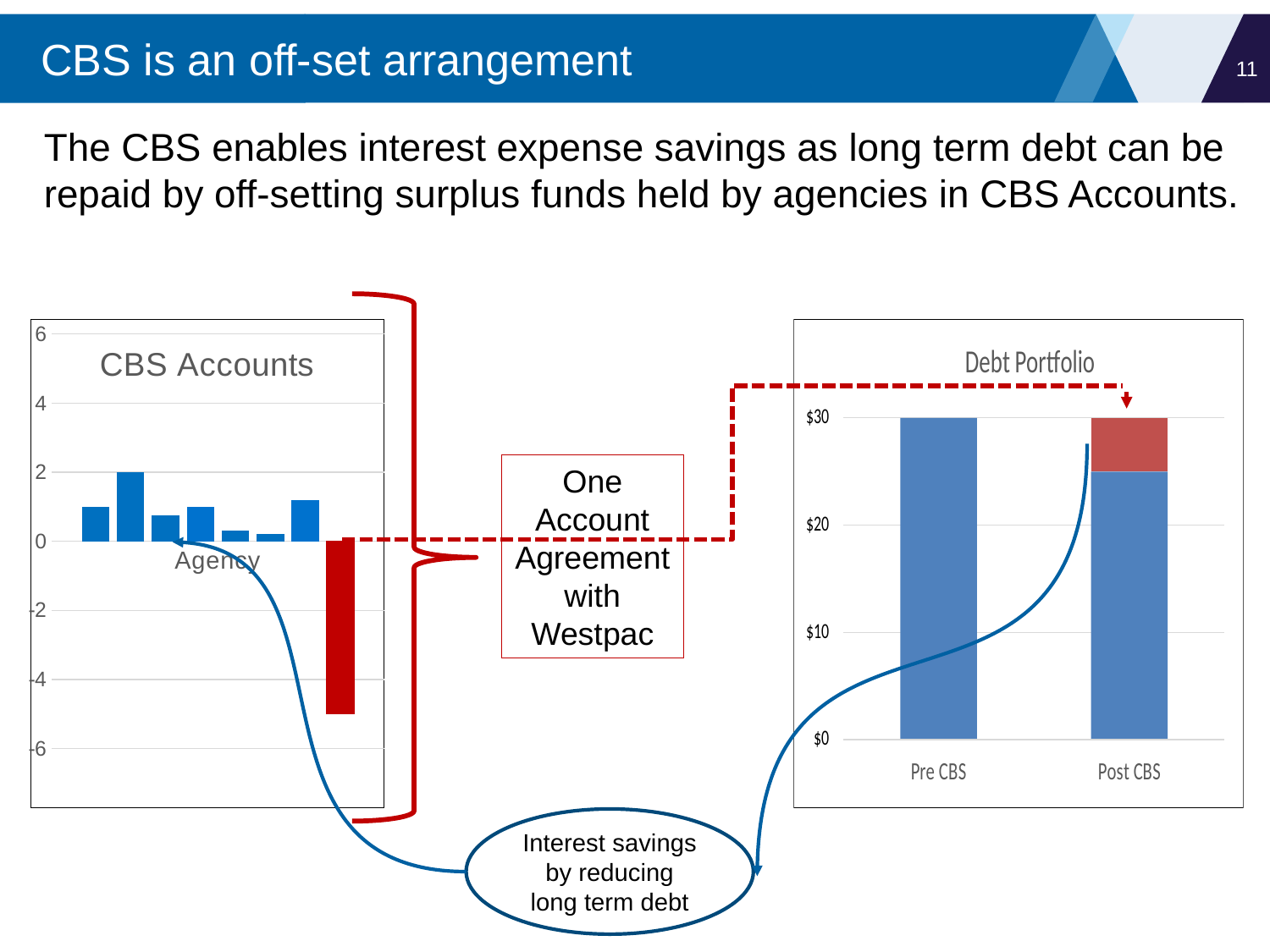
How many bars are plotted in the CBS Accounts chart? 8 What type of chart is the Debt Portfolio chart on the right? Bar chart In the Debt Portfolio chart, is the Pre CBS bar greater or less than $20? greater What type of chart is the CBS Accounts chart on the left? Bar chart In the Debt Portfolio chart, what is the value of the Pre CBS bar? $30 What is the title of the chart on the right of the slide? Debt Portfolio In the Debt Portfolio chart, is the blue portion of the Post CBS bar greater or less than $20? greater In the CBS Accounts chart, is the value of the red bar greater or less than 0? less How many categories are shown on the x axis of the Debt Portfolio chart? 2 What is the x-axis label of the CBS Accounts chart? Agency How many blue bars are there in the CBS Accounts chart? 7